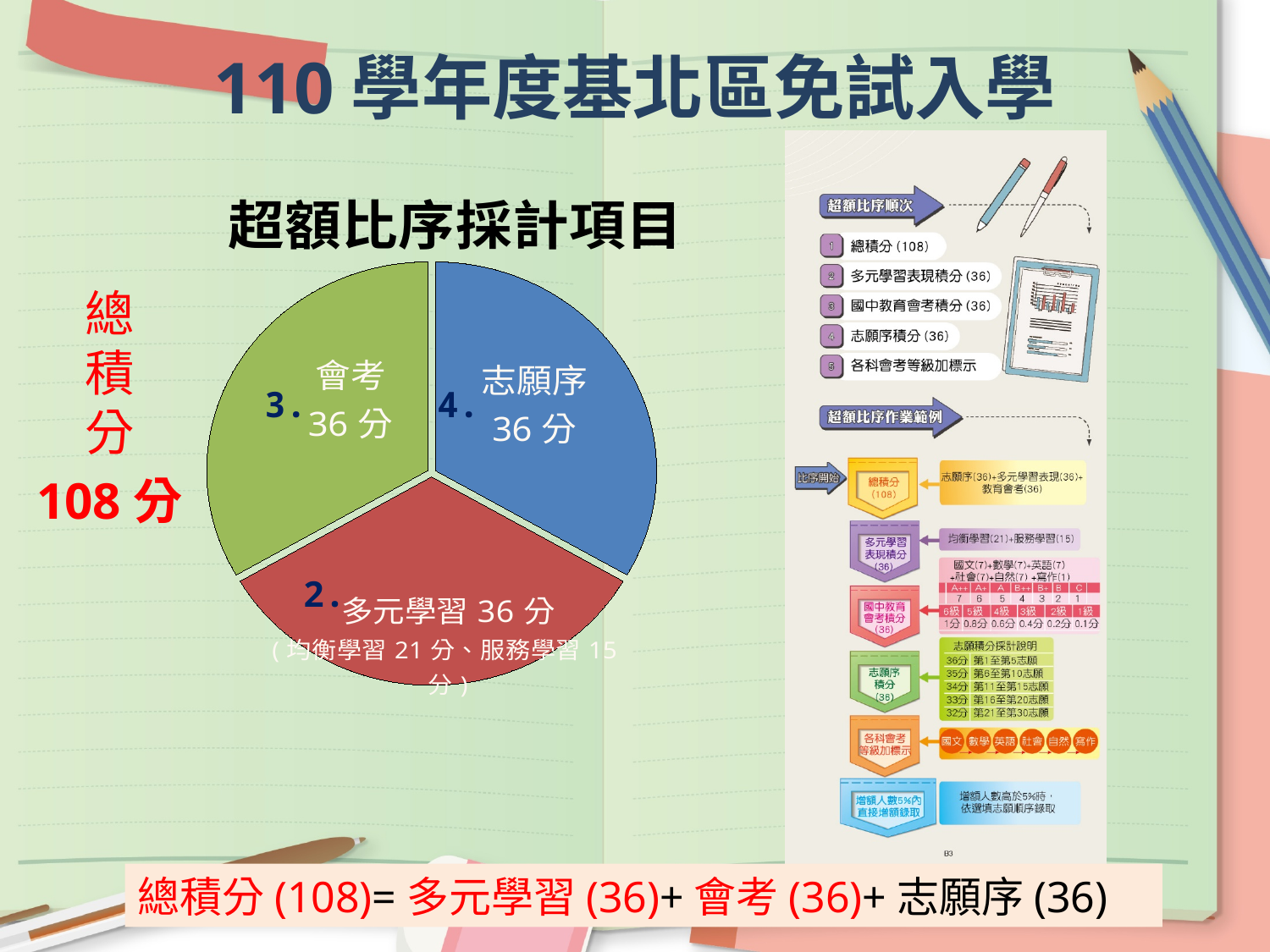
In the pie chart, what is the value for 多元學習? 36 分 What is the difference between the values for 志願序 and 會考 in the pie chart? 0 分 What is the total score (總積分) shown next to the pie chart? 108 分 According to the label on the 多元學習 slice, how many points is 均衡學習 worth? 21 分 In the pie chart, what is the value for 志願序? 36 分 What kind of chart is shown under the title 超額比序採計項目? pie chart How many slices does the pie chart 超額比序採計項目 have? 3 What share of the total 108 分 does the 多元學習 slice represent? one third In the pie chart, what is the value for 會考? 36 分 Which colour is the 志願序 slice of the pie chart? blue According to the label on the 多元學習 slice, how many points is 服務學習 worth? 15 分 What is the title of the pie chart? 超額比序採計項目